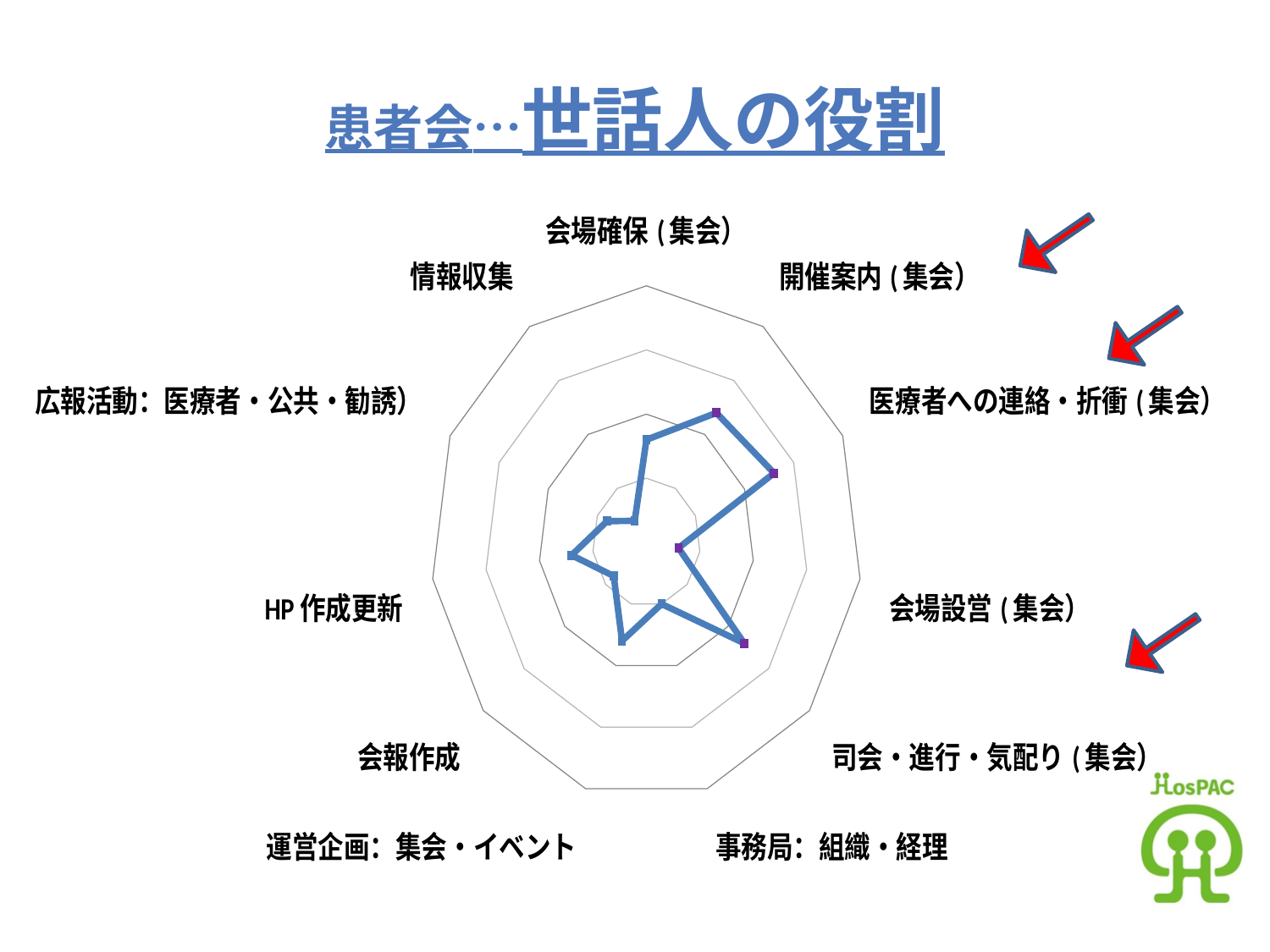
How many categories (axes) does the radar chart have? 11 How many data series are plotted on the radar chart? 1 Which has the larger value on the radar chart, 運営企画：集会・イベント or 会報作成? 運営企画：集会・イベント What is the title of the slide containing the radar chart? 患者会…世話人の役割 Which has the larger value on the radar chart, 司会・進行・気配り(集会) or 事務局：組織・経理? 司会・進行・気配り(集会) Which has the larger value on the radar chart, 開催案内(集会) or 会場確保(集会)? 開催案内(集会) Which category is plotted at the top of the radar chart? 会場確保(集会) What kind of chart is shown on the slide? Radar chart